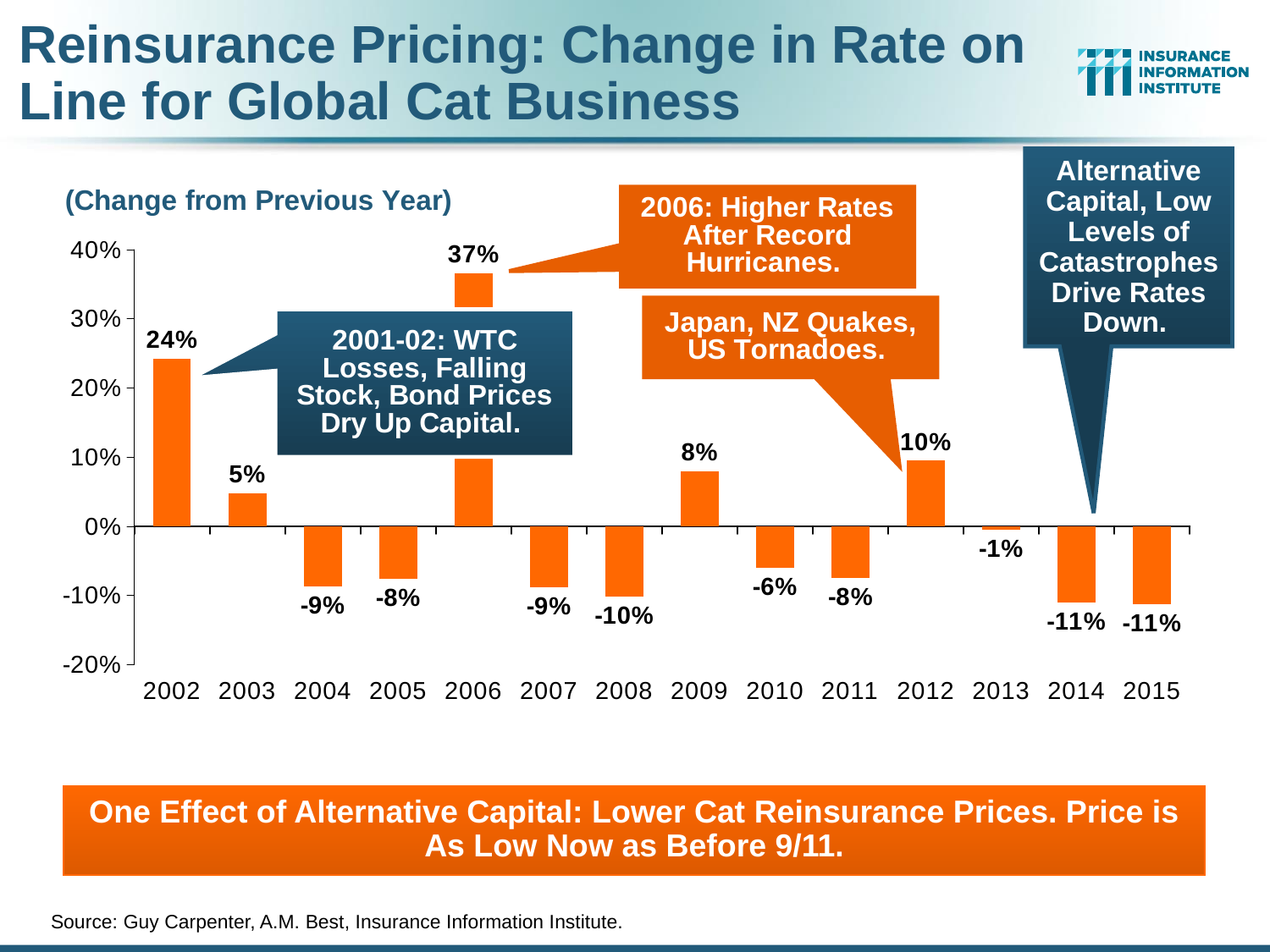
What is the value shown for 2013? -1% Which year has the highest change in rate on line? 2006 What is the difference between the values for 2012 and 2009? 2 percentage points What is the value shown for 2012? 10% What kind of chart is shown on the slide? Bar chart How many years are shown on the x axis? 14 What is the difference between the values for 2006 and 2002? 13 percentage points Which is larger, the value for 2012 or the value for 2009? 2012 What is the value shown for 2002? 24% What is the change in rate on line for 2006? 37% Which is larger, the value for 2003 or the value for 2009? 2009 What does the subtitle above the chart say the values represent? Change from Previous Year